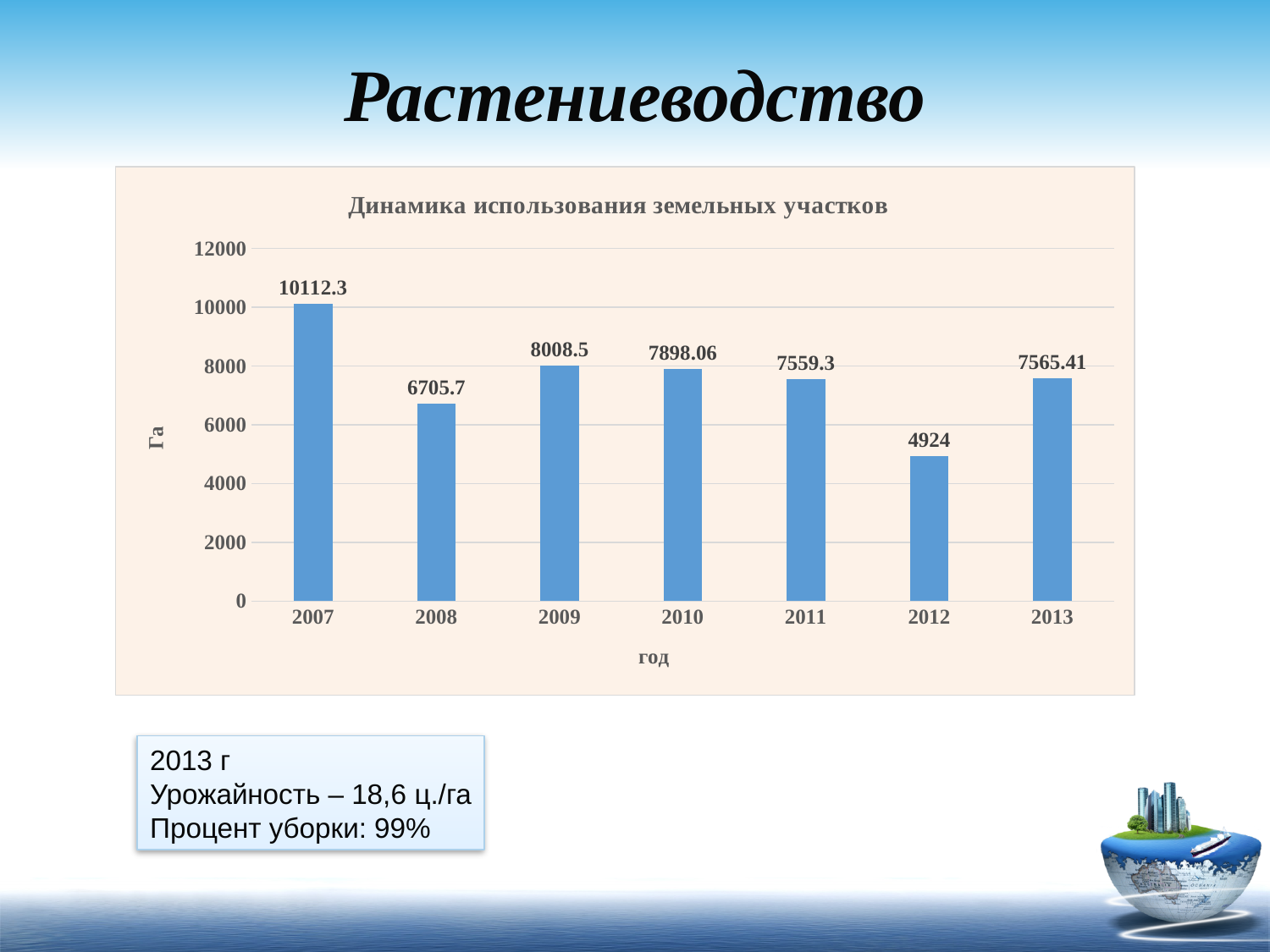
What is the title of the chart on the slide? Динамика использования земельных участков How many years are shown on the x axis of the chart? 7 What is the difference between the values for 2007 and 2008? 3406.6 What is the value for 2012 in the chart? 4924 What kind of chart is shown on the slide? bar chart Is the value for 2012 greater or less than 6000? less Which year has the highest value in the chart? 2007 What is the difference between the values for 2007 and 2012? 5188.3 What is the value for 2010 in the chart? 7898.06 What is the value for 2007 in the chart "Динамика использования земельных участков"? 10112.3 Which year has the lowest value in the chart? 2012 Which is larger, the value for 2009 or the value for 2008? 2009